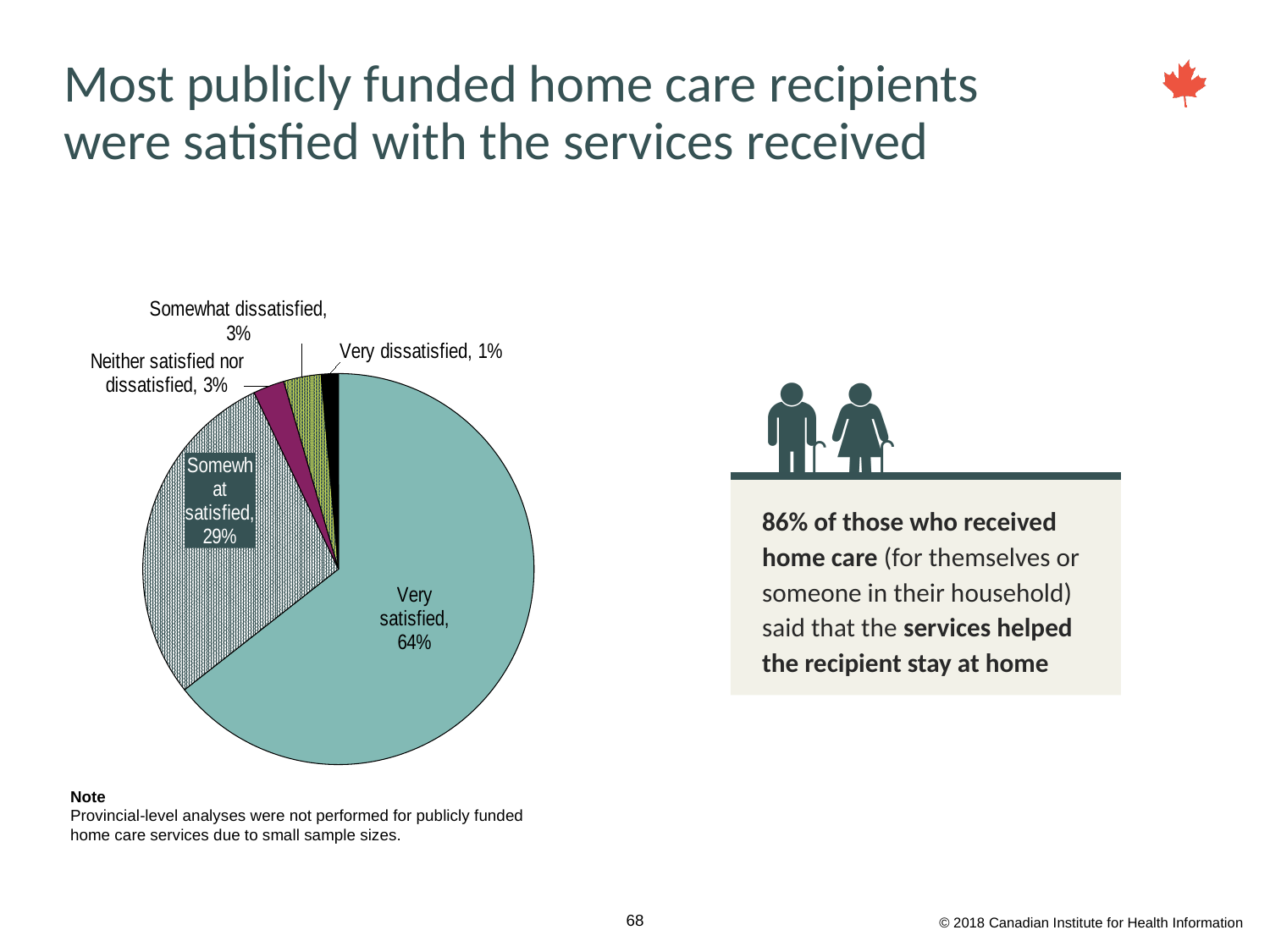
What kind of chart is shown on the slide? pie chart What percentage of publicly funded home care recipients were very satisfied? 64% What percentage of recipients were neither satisfied nor dissatisfied? 3% What percentage of recipients were very dissatisfied? 1% What percentage of recipients were somewhat satisfied? 29% What is the difference in percentage points between the very satisfied and somewhat satisfied slices? 35 What colour is the very satisfied slice? teal Which category has the smallest share of the pie? Very dissatisfied Which category has the largest share of the pie? Very satisfied What is the combined share of the very satisfied and somewhat satisfied slices? 93% Which is larger, the somewhat satisfied slice or the somewhat dissatisfied slice? Somewhat satisfied How many slices does the pie chart have? 5